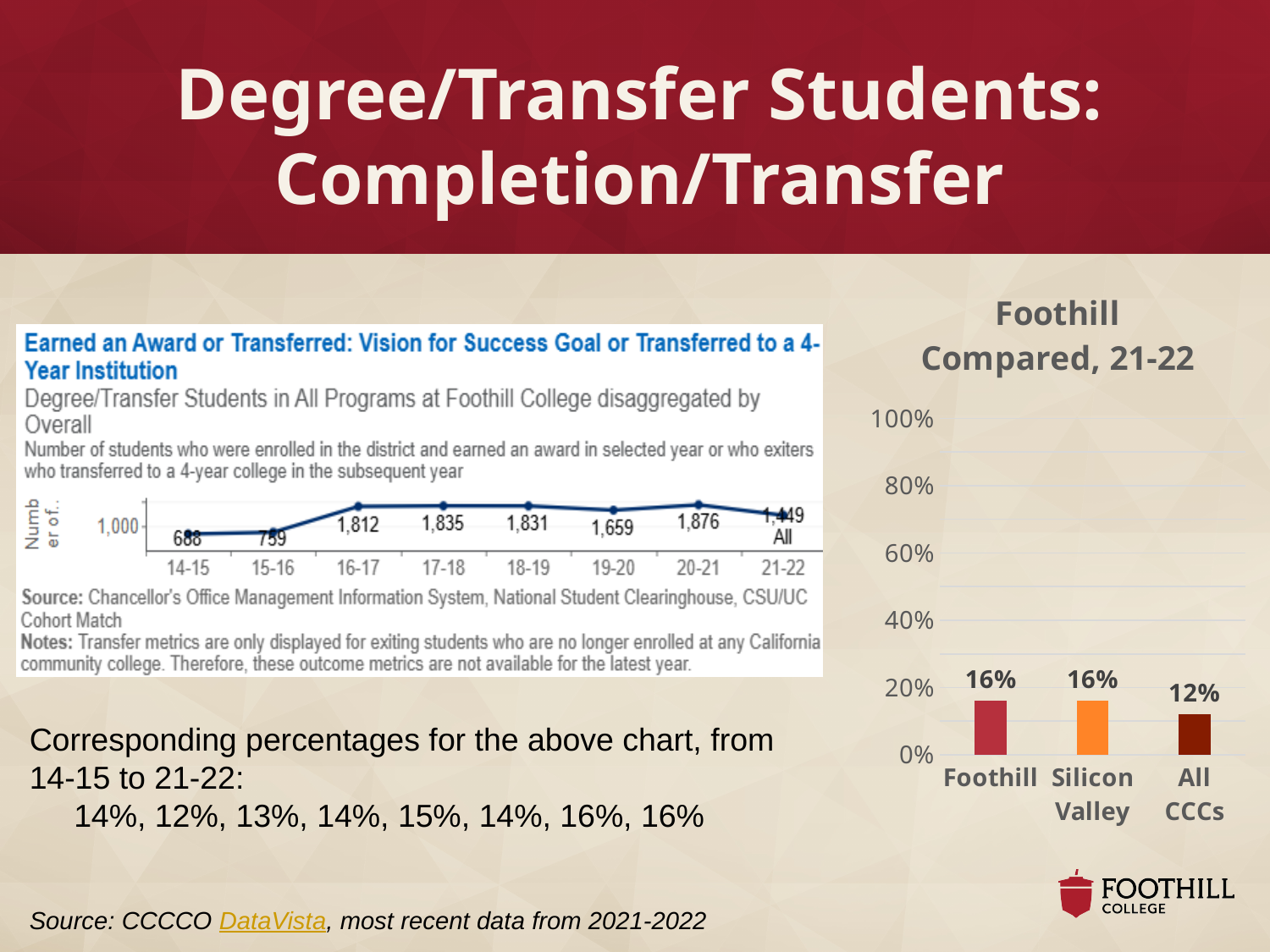
In the 'Foothill Compared, 21-22' chart, what is the value for Foothill? 16% In the 'Earned an Award or Transferred' line chart on the left, which is larger, the value for 16-17 or the value for 19-20? 16-17 In the 'Foothill Compared, 21-22' chart, what is the difference between the Foothill value and the All CCCs value? 4% In the 'Earned an Award or Transferred' line chart on the left, which year has the highest value? 20-21 In the 'Earned an Award or Transferred' line chart on the left, what is the difference between the 20-21 value and the 19-20 value? 217 What kind of chart is the 'Foothill Compared, 21-22' chart on the right? Bar chart In the 'Foothill Compared, 21-22' chart, which category has the lowest value? All CCCs How many data points are plotted in the 'Earned an Award or Transferred' line chart on the left? 8 In the 'Foothill Compared, 21-22' chart, what is the value for All CCCs? 12% In the 'Earned an Award or Transferred' line chart on the left, which year has the lowest value? 14-15 How many categories are shown in the 'Foothill Compared, 21-22' chart? 3 In the 'Earned an Award or Transferred' line chart on the left, what is the value for 17-18? 1,835